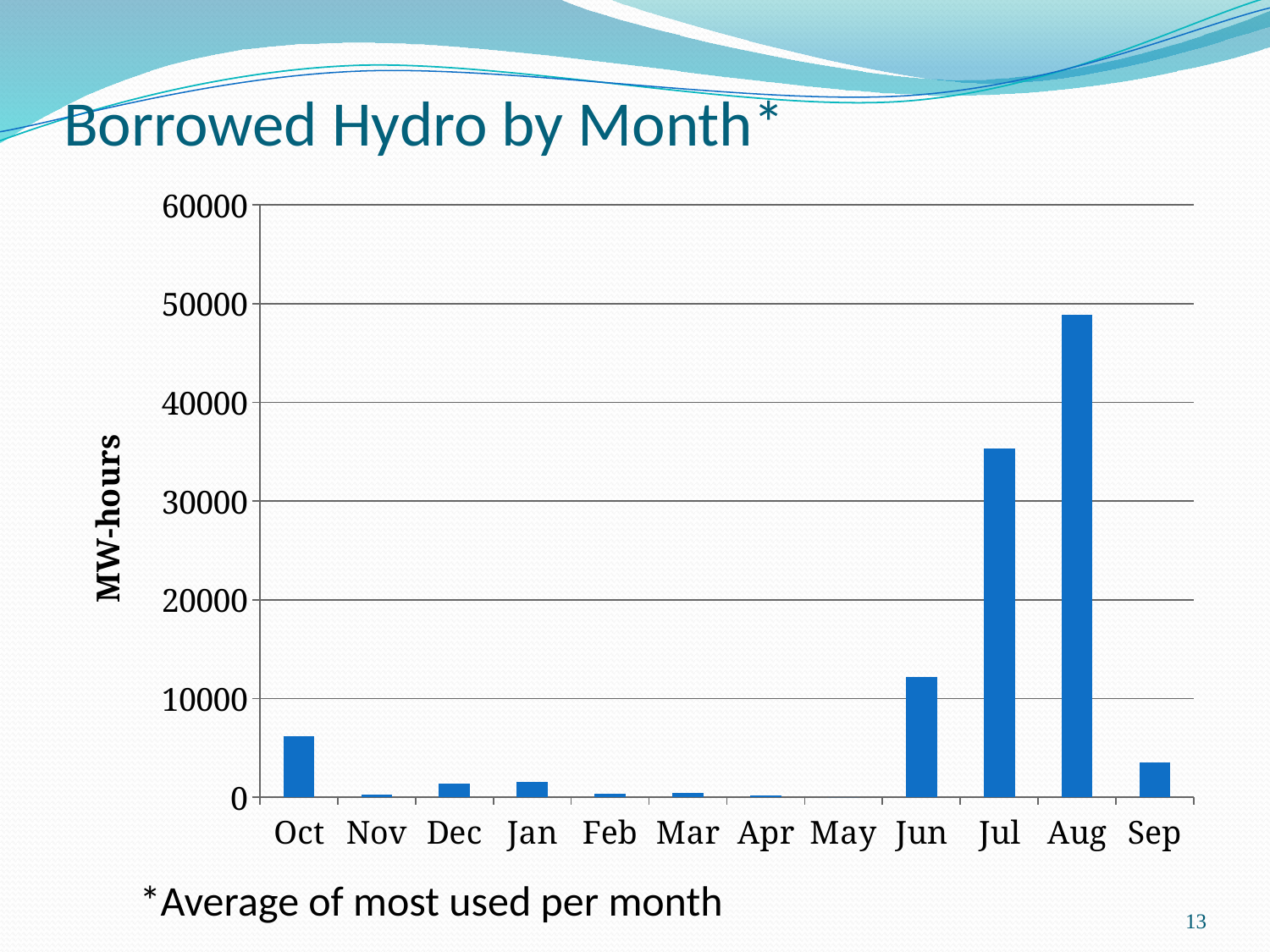
Which is larger, the value for Jul or the value for Aug? Aug Is the value for Oct greater or less than 10000? less Is the value for Jul greater or less than 30000? greater Which month has the lowest borrowed hydro? May Is the value for Jun greater or less than 10000? greater Which is larger, the value for Oct or the value for Sep? Oct How many months are plotted on the x axis? 12 What is the label on the y axis? MW-hours What kind of chart is shown on the slide? bar chart Which month has the highest borrowed hydro? Aug